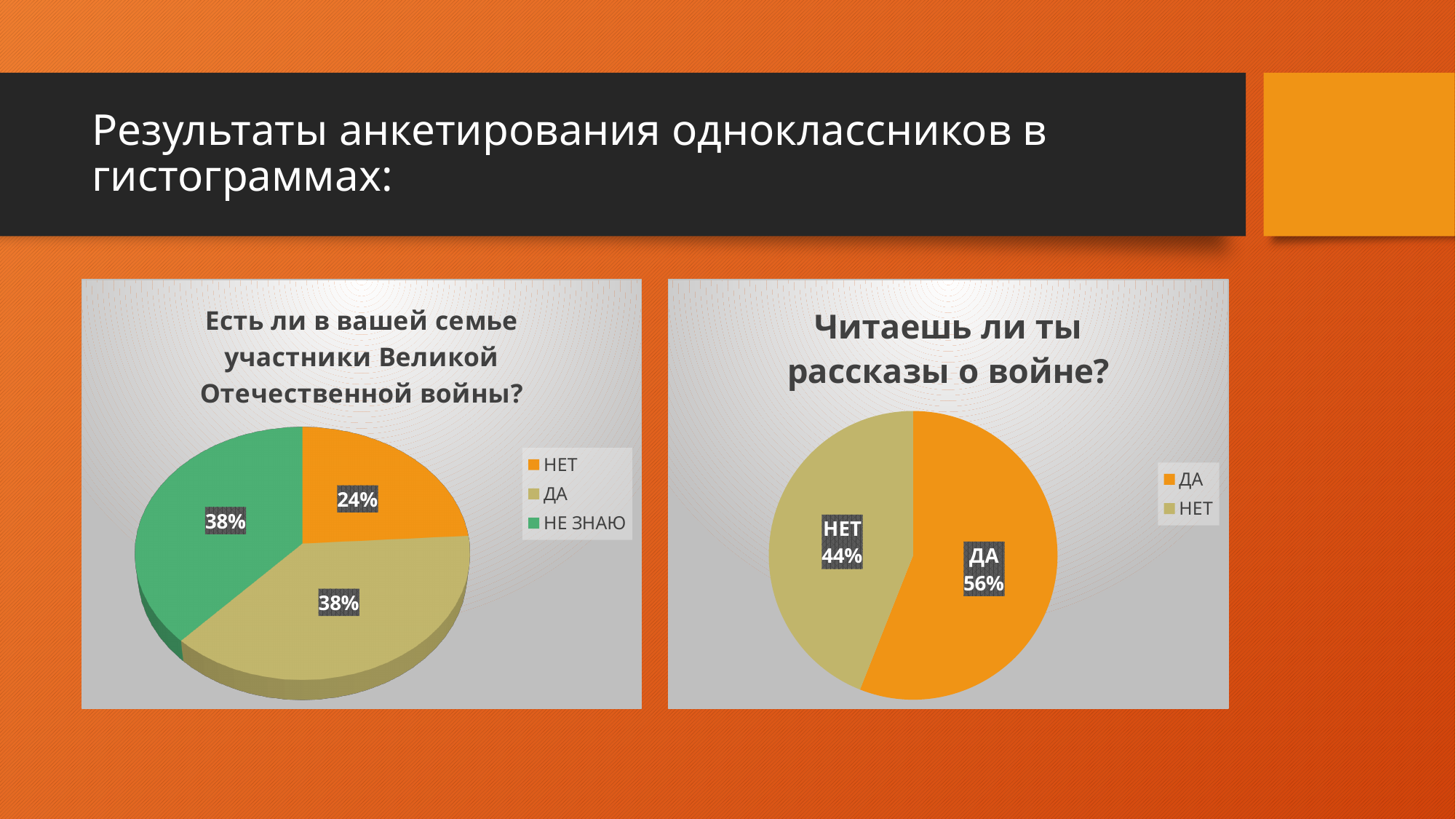
In the left chart ("Есть ли в вашей семье участники Великой Отечественной войны?"), what share of respondents answered НЕ ЗНАЮ? 38% In the right chart ("Читаешь ли ты рассказы о войне?"), what share of respondents answered НЕТ? 44% In the left chart ("Есть ли в вашей семье участники Великой Отечественной войны?"), what colour is the НЕ ЗНАЮ slice? Green In the right chart ("Читаешь ли ты рассказы о войне?"), how many entries does the legend list? 2 In the left chart ("Есть ли в вашей семье участники Великой Отечественной войны?"), which answer has the smallest share? НЕТ In the right chart ("Читаешь ли ты рассказы о войне?"), what is the difference between the ДА share and the НЕТ share? 12% In the left chart ("Есть ли в вашей семье участники Великой Отечественной войны?"), what is the difference between the ДА share and the НЕТ share? 14% In the left chart ("Есть ли в вашей семье участники Великой Отечественной войны?"), how many slices does the pie have? 3 In the right chart ("Читаешь ли ты рассказы о войне?"), which answer has the larger share? ДА What type of chart is the right chart ("Читаешь ли ты рассказы о войне?")? Pie chart In the right chart ("Читаешь ли ты рассказы о войне?"), what share of respondents answered ДА? 56% In the left chart ("Есть ли в вашей семье участники Великой Отечественной войны?"), what share of respondents answered НЕТ? 24%